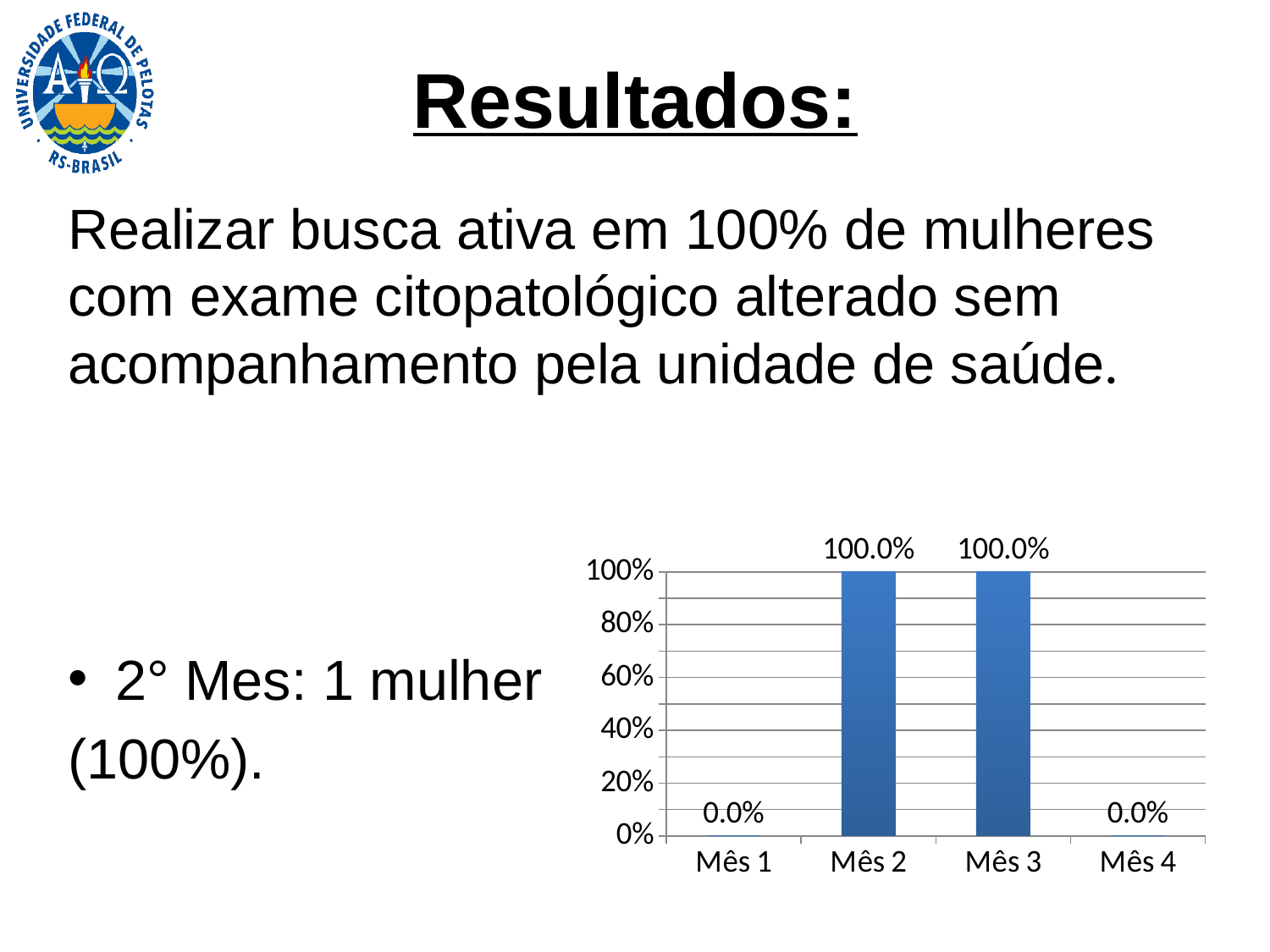
What kind of chart is shown on the slide? bar chart How many months (categories) are shown on the x axis of the chart? 4 What is the highest tick value shown on the vertical axis of the chart? 100% Is the value for Mês 2 greater or less than 80%? greater What is the difference between the values for Mês 2 and Mês 1? 100.0% What is the value for Mês 3? 100.0% Which months have the lowest value in the chart? Mês 1 and Mês 4 What is the value for Mês 4? 0.0% What is the value for Mês 1? 0.0% Which is larger, the value for Mês 3 or the value for Mês 4? Mês 3 Which months have the highest value in the chart? Mês 2 and Mês 3 What is the value for Mês 2? 100.0%